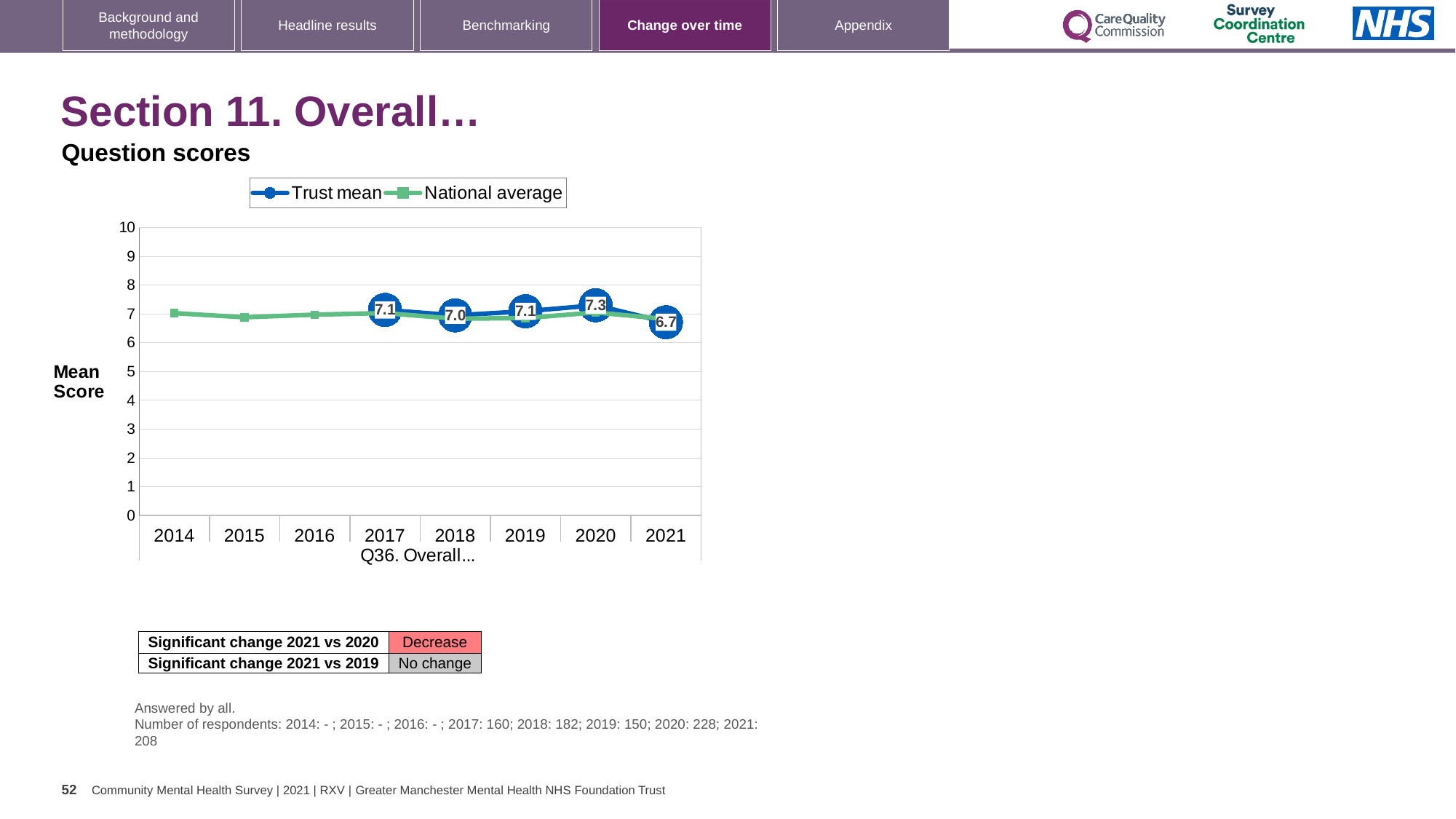
What kind of chart is shown on the slide? line chart What is the Trust mean score for 2021? 6.7 How many years are shown on the x axis of the chart? 8 Is the National average value for 2014 greater or less than 5? greater How many series does the chart legend list? 2 What is the Trust mean score for 2020? 7.3 In which year is the Trust mean score highest? 2020 In which year is the Trust mean score lowest? 2021 What is the difference between the Trust mean score in 2020 and in 2021? 0.6 Does the Trust mean score rise or fall from 2020 to 2021? fall What is the Trust mean score for 2018? 7.0 Which year has the larger Trust mean score, 2017 or 2018? 2017